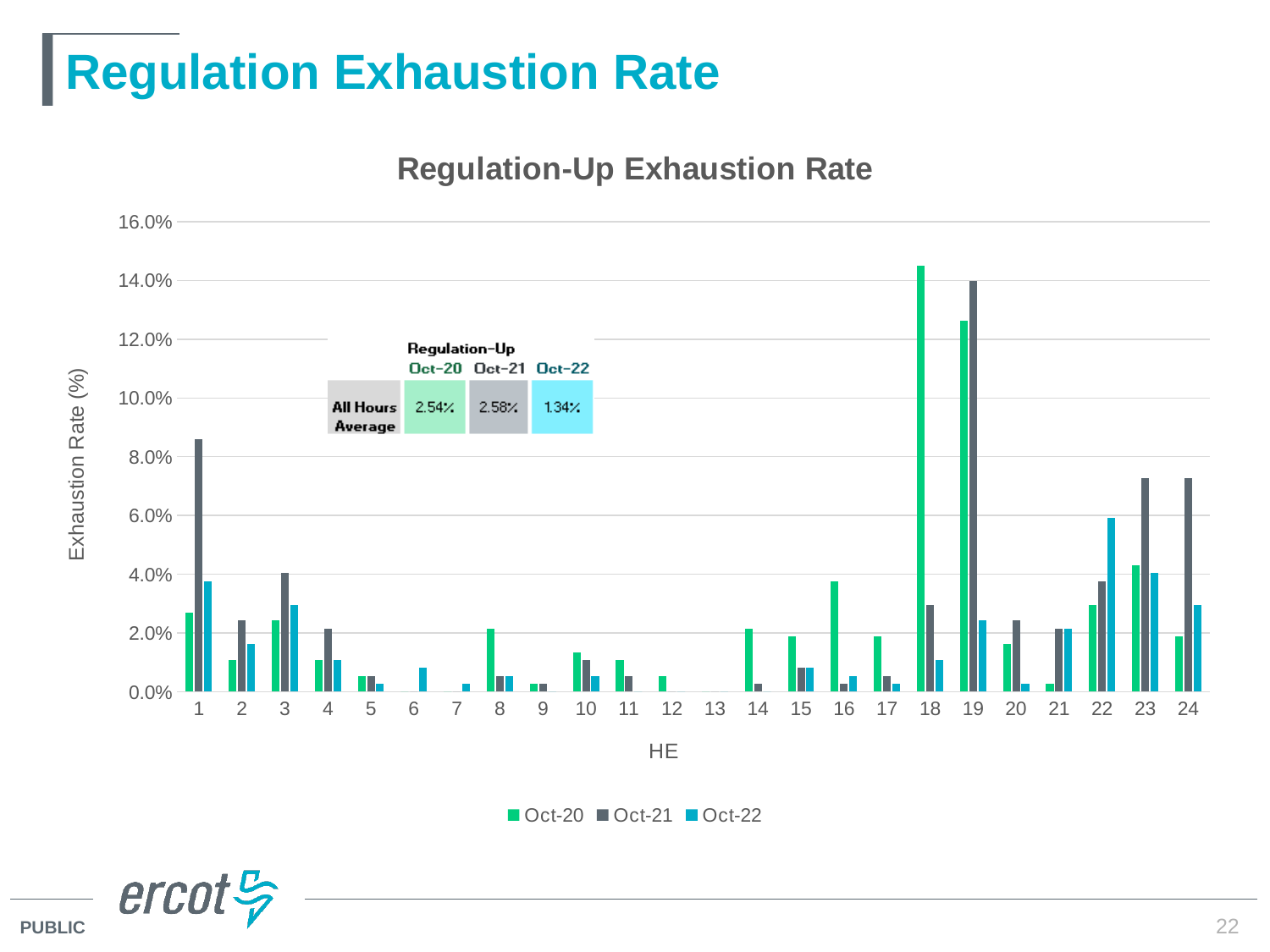
Which month has the highest All Hours Average in the inset table? Oct-21 At which HE does the Oct-20 series reach its highest value? 18 According to the inset table, what is the All Hours Average for Oct-20? 2.54% What is the label of the y axis? Exhaustion Rate (%) How many hour-ending (HE) categories are shown on the x axis? 24 How many series does the legend list? 3 Is the Oct-20 value at HE 18 greater or less than 14.0%? greater At which HE does the Oct-21 series reach its highest value? 19 What is the title of the chart? Regulation-Up Exhaustion Rate What kind of chart is shown on the slide? Bar chart According to the inset table, what is the All Hours Average for Oct-22? 1.34% At HE 1, which is larger: the Oct-20 value or the Oct-21 value? Oct-21